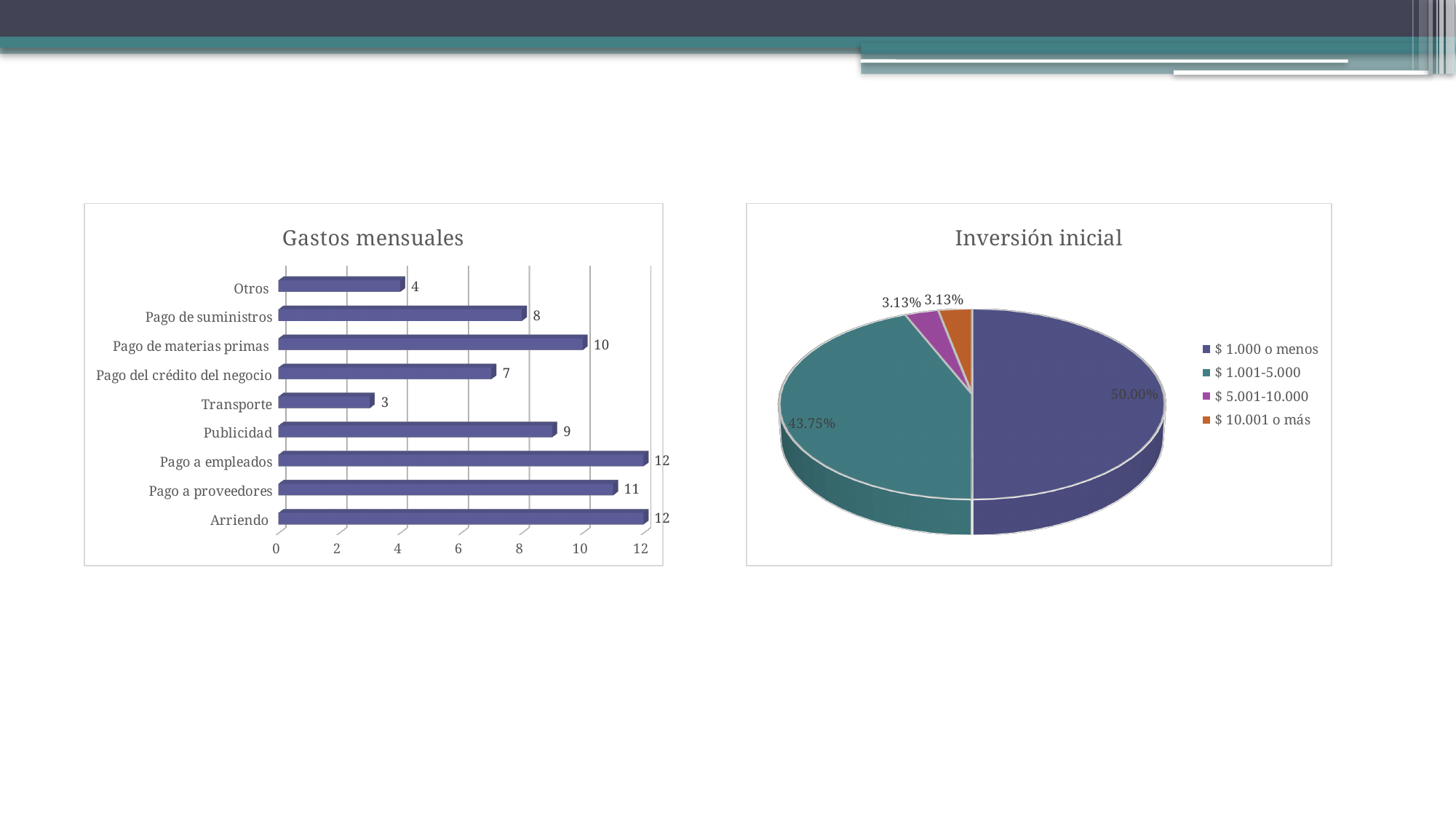
In the 'Gastos mensuales' chart, what is the difference between Pago a empleados and Otros? 8 In the 'Gastos mensuales' chart, which is larger: Publicidad or Pago de suministros? Publicidad How many categories are shown in the 'Gastos mensuales' chart? 9 In the 'Inversión inicial' chart, what share does '$ 1.001-5.000' have? 43.75% In the 'Gastos mensuales' chart, what is the value for Pago de materias primas? 10 In the 'Inversión inicial' chart, which category has the largest share? $ 1.000 o menos How many entries does the legend of the 'Inversión inicial' chart list? 4 In the 'Gastos mensuales' chart, what is the value for Transporte? 3 What kind of chart is 'Inversión inicial'? Pie chart In the 'Gastos mensuales' chart, which category has the lowest value? Transporte In the 'Inversión inicial' chart, what is the difference between the shares of '$ 1.000 o menos' and '$ 1.001-5.000'? 6.25% What kind of chart is 'Gastos mensuales'? Bar chart